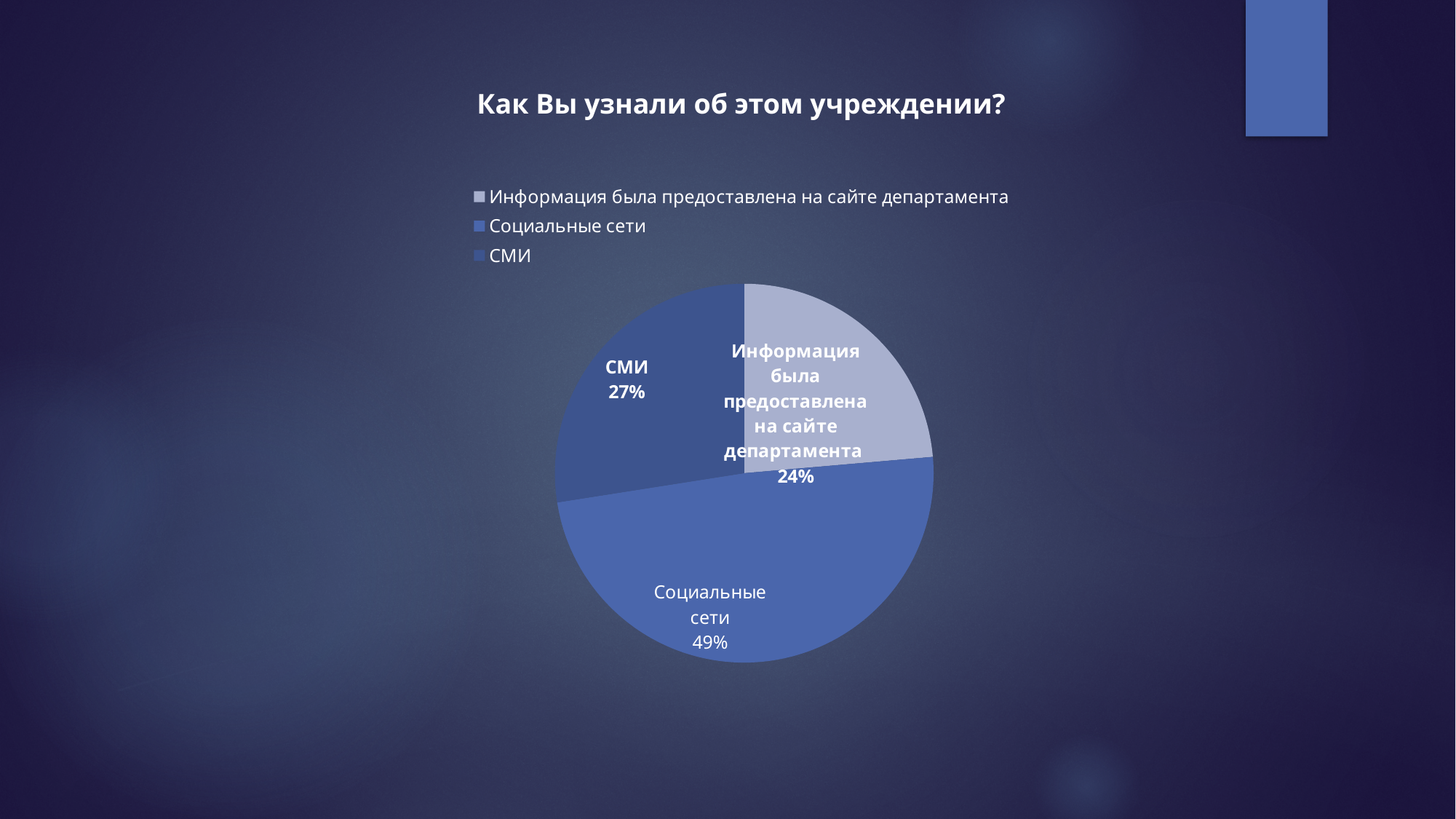
What share of the pie does "Информация была предоставлена на сайте департамента" represent? 24% What share of the pie does "Социальные сети" represent? 49% Is the share for "Социальные сети" greater or less than 50%? less What share of the pie does "СМИ" represent? 27% How many categories (slices) does the pie chart have? 3 What type of chart is shown on the slide? pie chart How many entries does the legend list? 3 Which category has the largest share of the pie? Социальные сети What is the title of the chart? Как Вы узнали об этом учреждении? What is the difference in percentage points between "Социальные сети" and "СМИ"? 22 Which is larger: the share for "СМИ" or the share for "Информация была предоставлена на сайте департамента"? СМИ Which category has the smallest share of the pie? Информация была предоставлена на сайте департамента